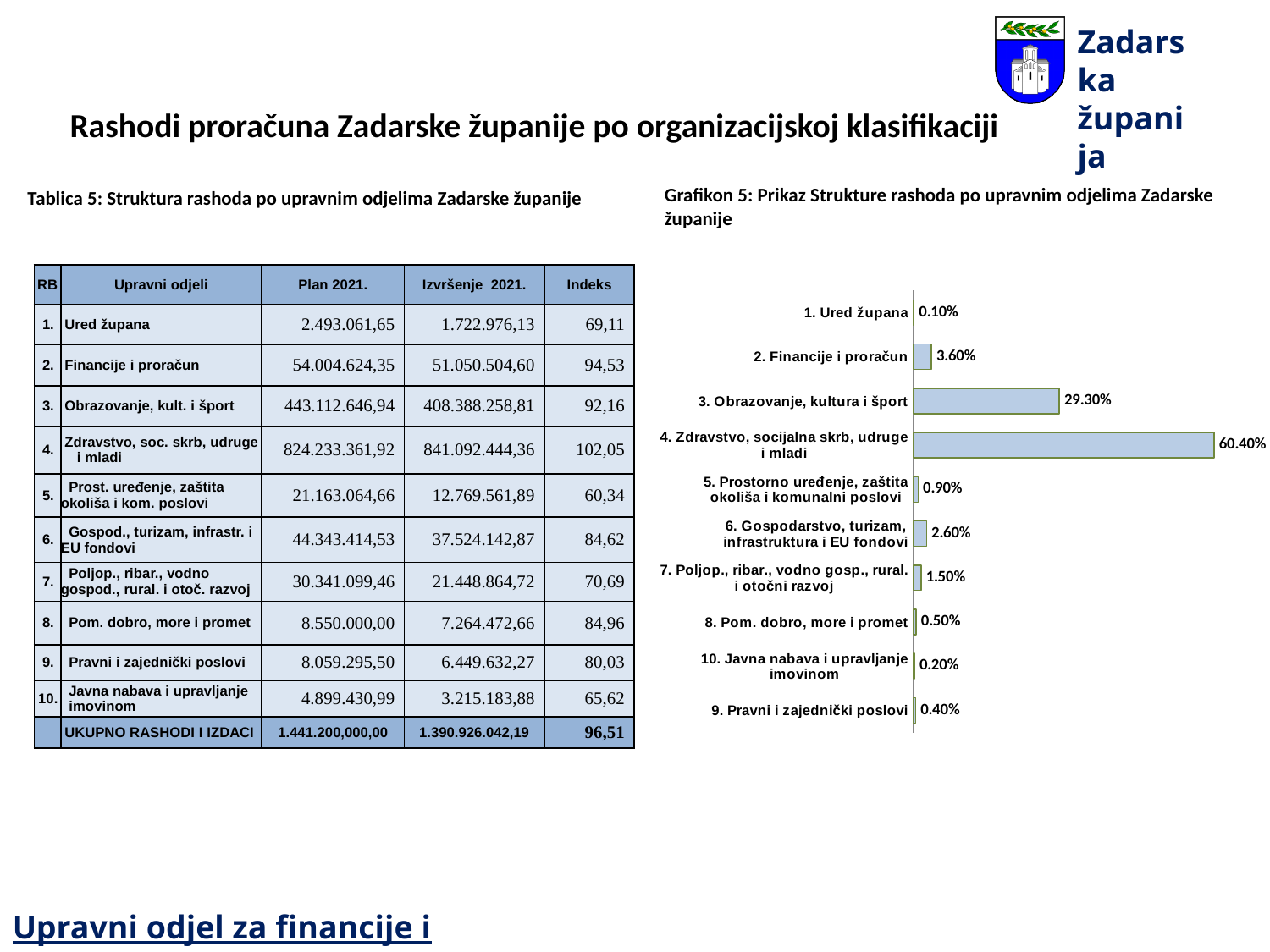
Which category has the highest value? 4. Zdravstvo, socijalna skrb, udruge i mladi What is the difference between the values for "4. Zdravstvo, socijalna skrb, udruge i mladi" and "3. Obrazovanje, kultura i šport"? 31.10% What is the value for "9. Pravni i zajednički poslovi"? 0.40% What is the value for "3. Obrazovanje, kultura i šport"? 29.30% What is the value for "4. Zdravstvo, socijalna skrb, udruge i mladi"? 60.40% Which is larger, the value for "6. Gospodarstvo, turizam, infrastruktura i EU fondovi" or "2. Financije i proračun"? 2. Financije i proračun How many categories are shown in the chart? 10 What kind of chart is shown on the slide? bar chart What is the value for "2. Financije i proračun"? 3.60% What is the value for "7. Poljop., ribar., vodno gosp., rural. i otočni razvoj"? 1.50% What is the title of the chart? Grafikon 5: Prikaz Strukture rashoda po upravnim odjelima Zadarske županije Which category has the lowest value? 1. Ured župana